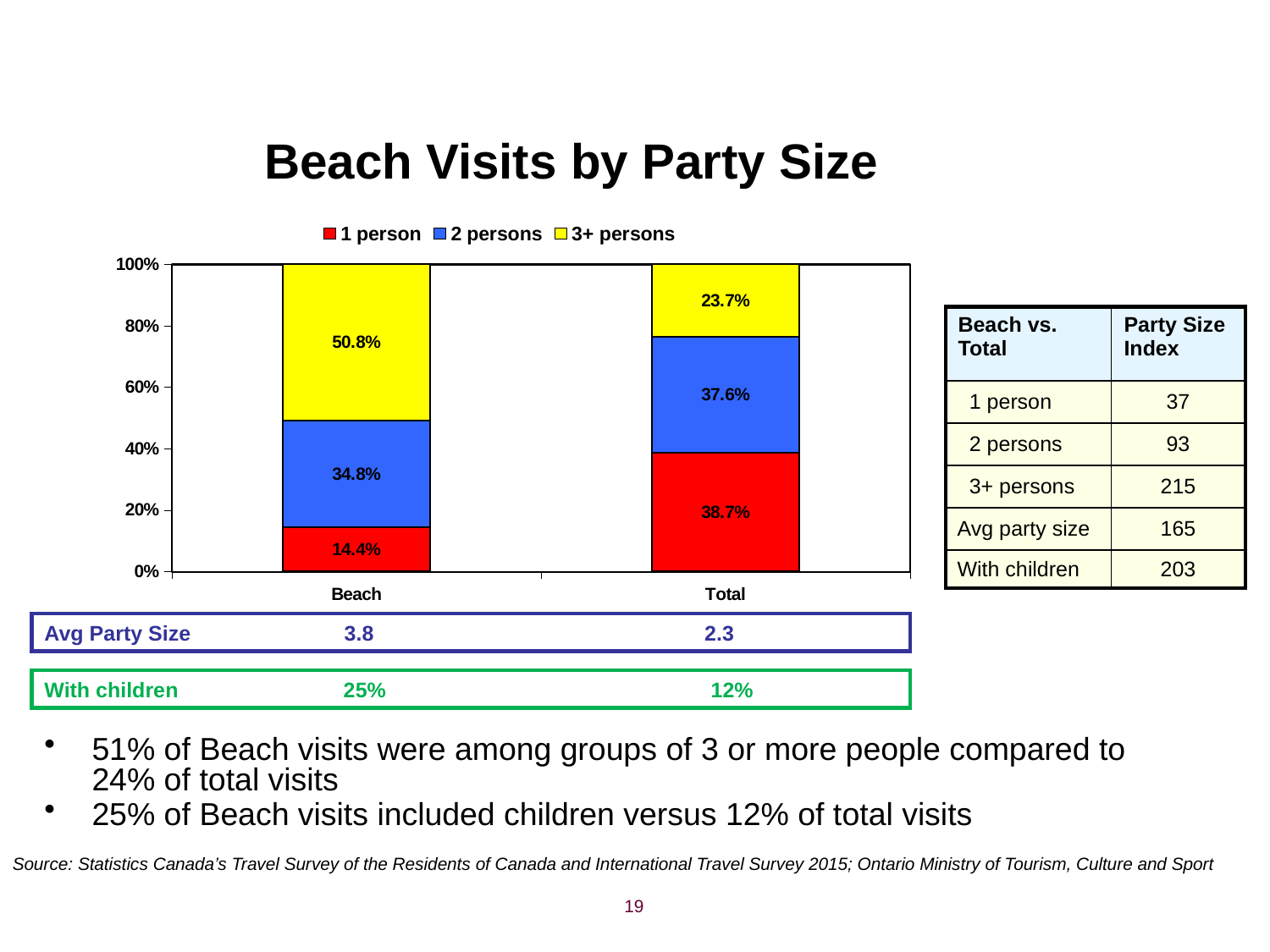
What percentage of Total visits were by 1 person? 38.7% Which party size has the smallest share of Total visits? 3+ persons What kind of chart is shown on the slide? Stacked bar chart What percentage of Beach visits were by 3+ persons? 50.8% What is the difference between the 3+ persons share for Beach and for Total? 27.1% What percentage of Beach visits were by 1 person? 14.4% Which colour represents the 2 persons series? Blue How many categories are shown on the x axis? 2 Is the 1 person share larger for Beach or for Total? Total Which party size has the largest share of Beach visits? 3+ persons What percentage of Total visits were by 2 persons? 37.6% How many series does the legend list? 3